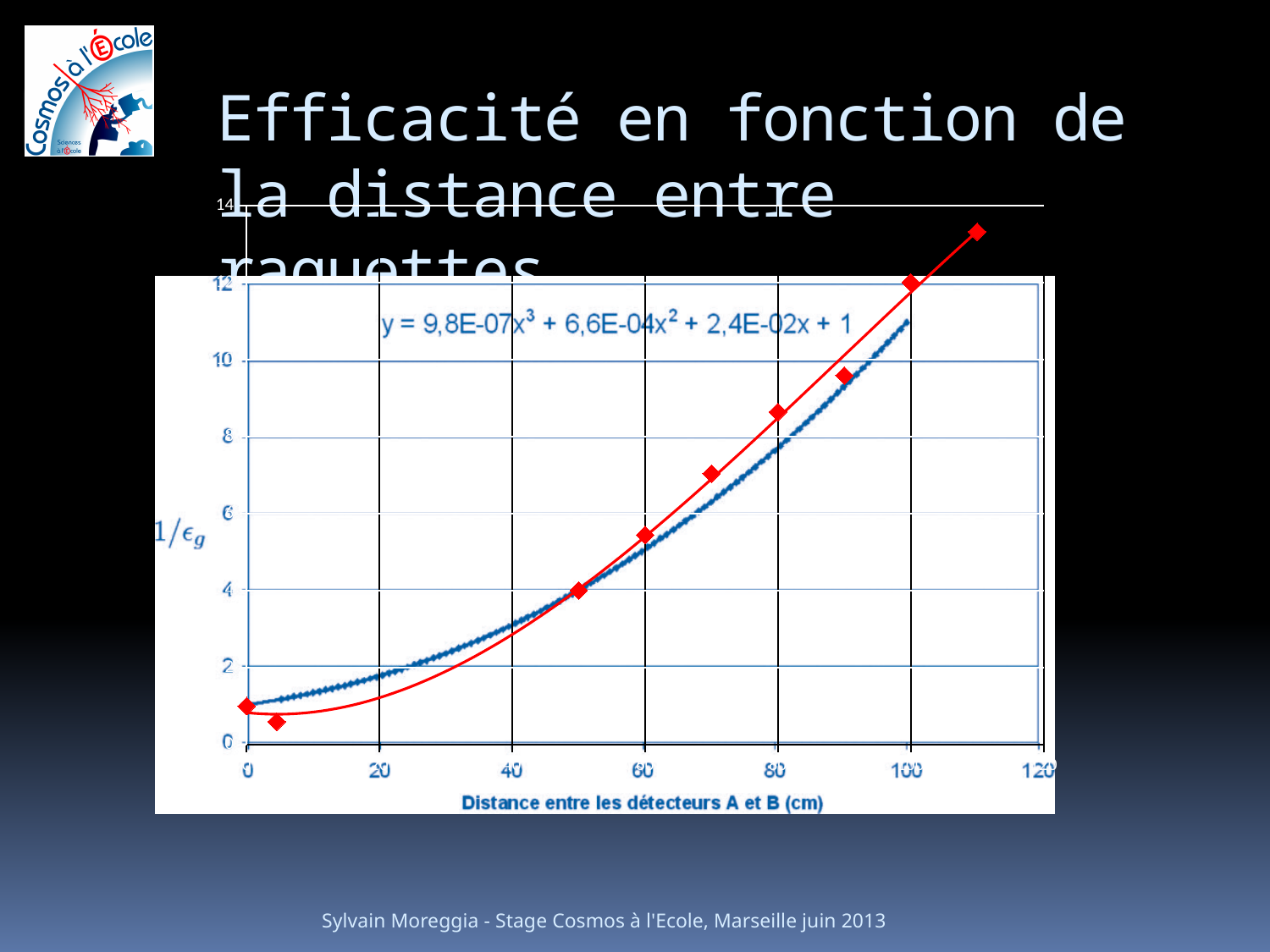
Is the red diamond value at 80 cm greater or less than 8? greater How many red diamond data points are plotted on the chart? 9 Is the red diamond value at 110 cm greater or less than 12? greater What is the x-axis title of the chart? Distance entre les détecteurs A et B (cm) Do the values of 1/εg rise or fall as the distance between detectors increases? rise Which is larger, the red diamond value at 100 cm or at 50 cm? 100 cm Is the red diamond value at 60 cm greater or less than 6? less What kind of chart is shown on the slide? scatter chart with fitted curves What fitted equation is printed on the chart? y = 9,8E-07x³ + 6,6E-04x² + 2,4E-02x + 1 Which red diamond point has the highest value of 1/εg? the point at 110 cm